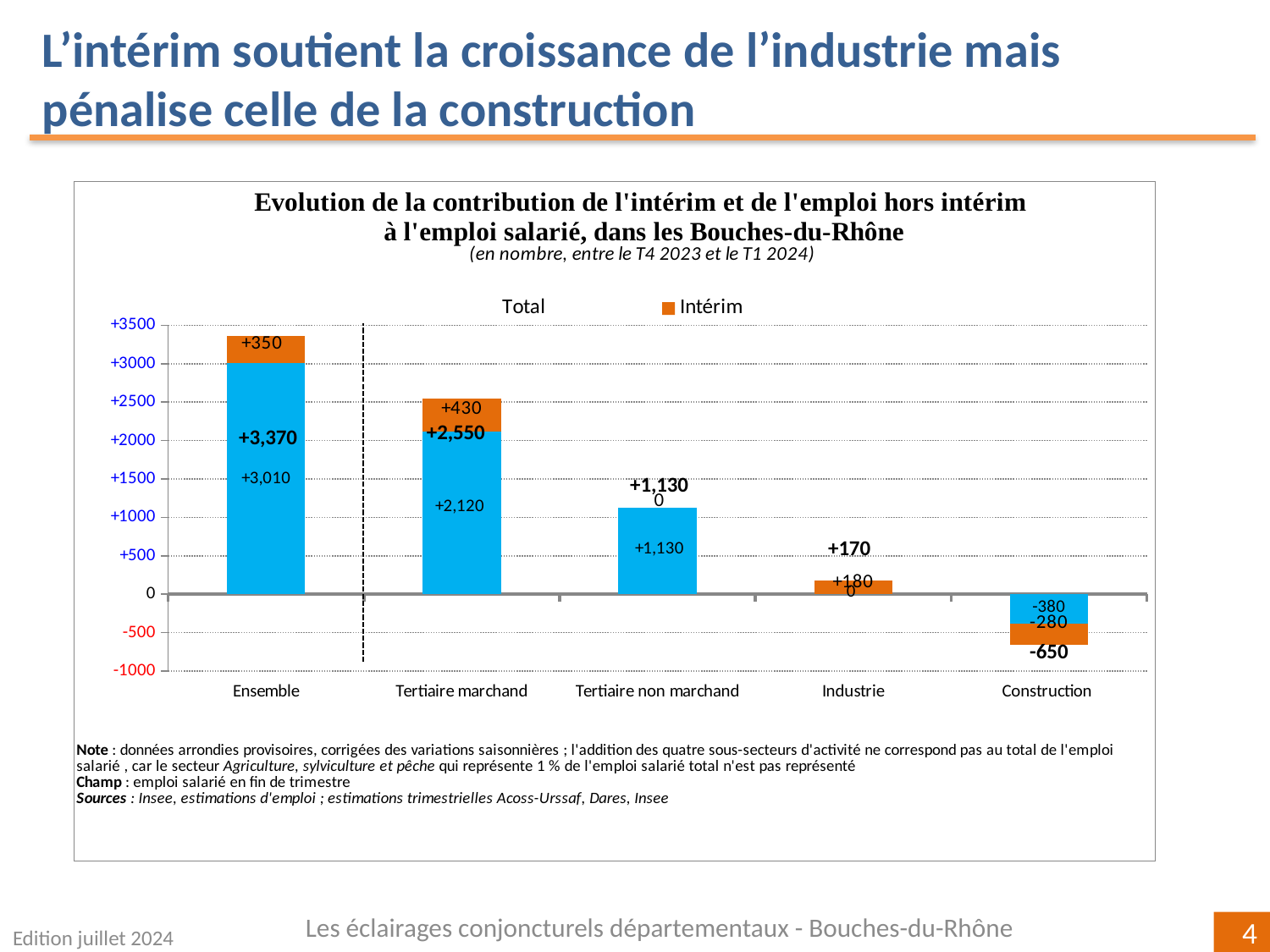
What is the Intérim value for Tertiaire marchand? +430 What is the Intérim value for Construction? -280 Which category has the highest total value? Ensemble Which is larger: the Intérim value for Tertiaire marchand or the Intérim value for Industrie? Tertiaire marchand What is the total value shown for Industrie? +170 What is the Intérim value for Ensemble? +350 What is the total value shown for Construction? -650 How many series does the legend list? 2 Which category has the lowest total value? Construction What kind of chart is shown on the slide? bar chart What is the difference between the total for Ensemble (+3,370) and the total for Tertiaire marchand (+2,550)? 820 How many categories are shown on the x axis of the chart? 5